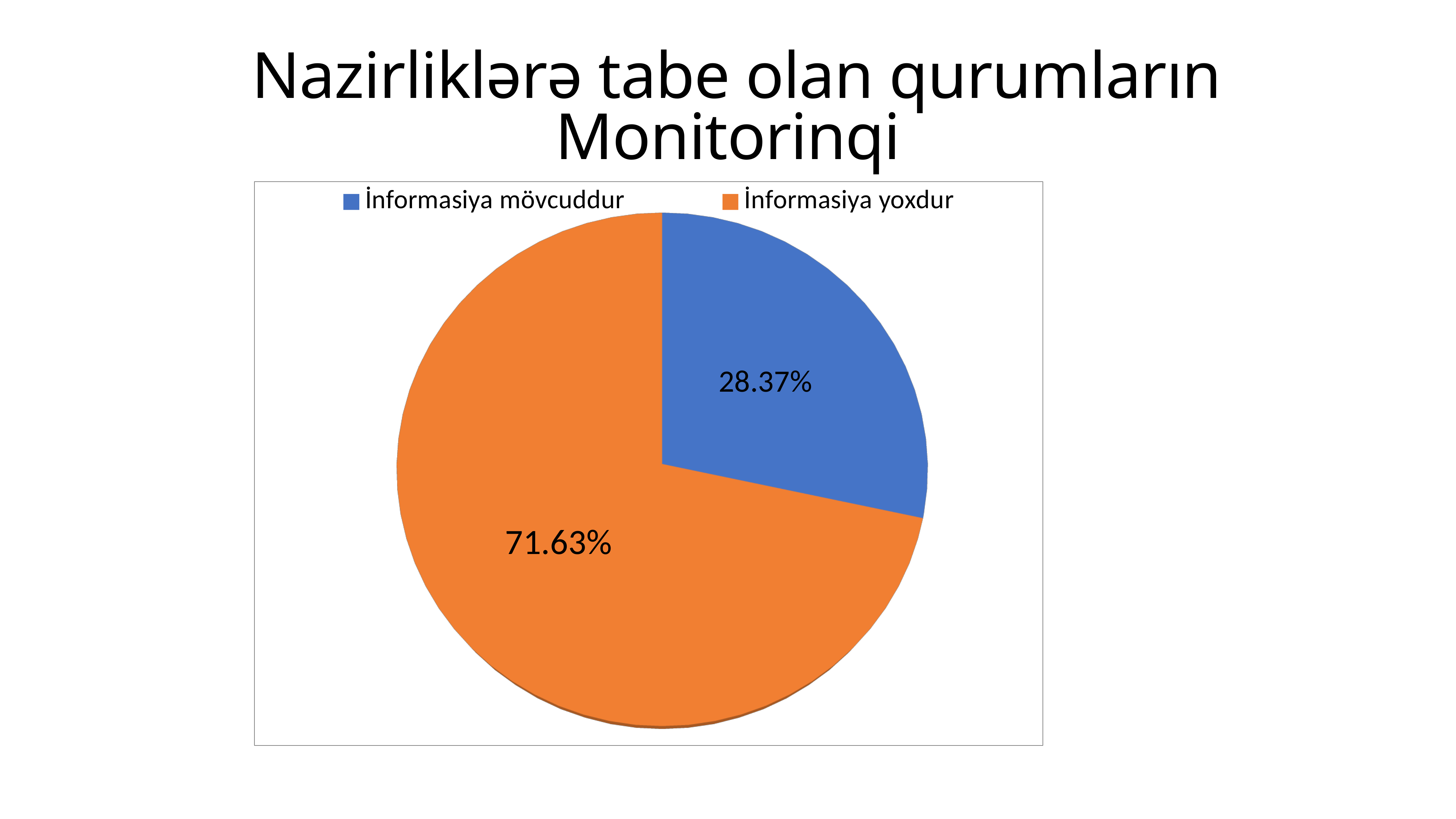
How many entries does the legend list? 2 What is the difference between the İnformasiya yoxdur and İnformasiya mövcuddur slices? 43.26% Which is larger, İnformasiya mövcuddur or İnformasiya yoxdur? İnformasiya yoxdur What share of the pie does İnformasiya mövcuddur take? 28.37% What kind of chart is shown on the slide? Pie chart What colour is the İnformasiya yoxdur slice? Orange What is the value for İnformasiya yoxdur? 71.63% Which category has the largest slice? İnformasiya yoxdur How many slices does the pie chart have? 2 What is the title of the slide? Nazirliklərə tabe olan qurumların Monitorinqi Which category has the smallest slice? İnformasiya mövcuddur What is the value for İnformasiya mövcuddur? 28.37%